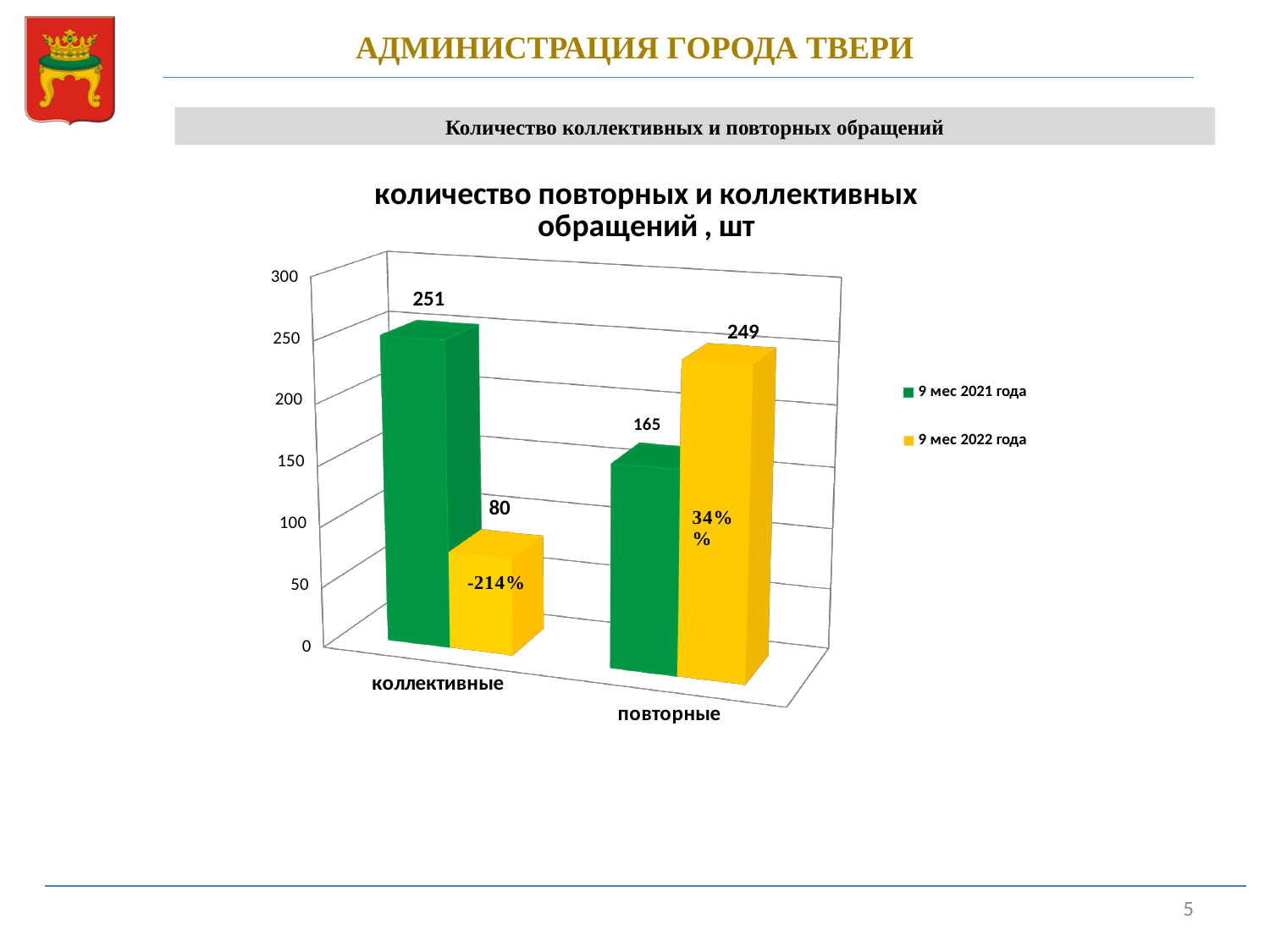
What kind of chart is shown on the slide? bar chart What is the value for коллективные in the 9 мес 2021 года series? 251 How many categories are shown on the x axis? 2 Which category has the highest value in the 9 мес 2021 года series? коллективные What is the value for повторные in the 9 мес 2022 года series? 249 How many series does the legend list? 2 What is the value for коллективные in the 9 мес 2022 года series? 80 What is the value for повторные in the 9 мес 2021 года series? 165 Which category has the lowest value in the 9 мес 2022 года series? коллективные What is the difference between the 9 мес 2022 года and 9 мес 2021 года values for повторные? 84 Which is larger for повторные: the 9 мес 2021 года value or the 9 мес 2022 года value? 9 мес 2022 года What is the difference between the 9 мес 2021 года and 9 мес 2022 года values for коллективные? 171